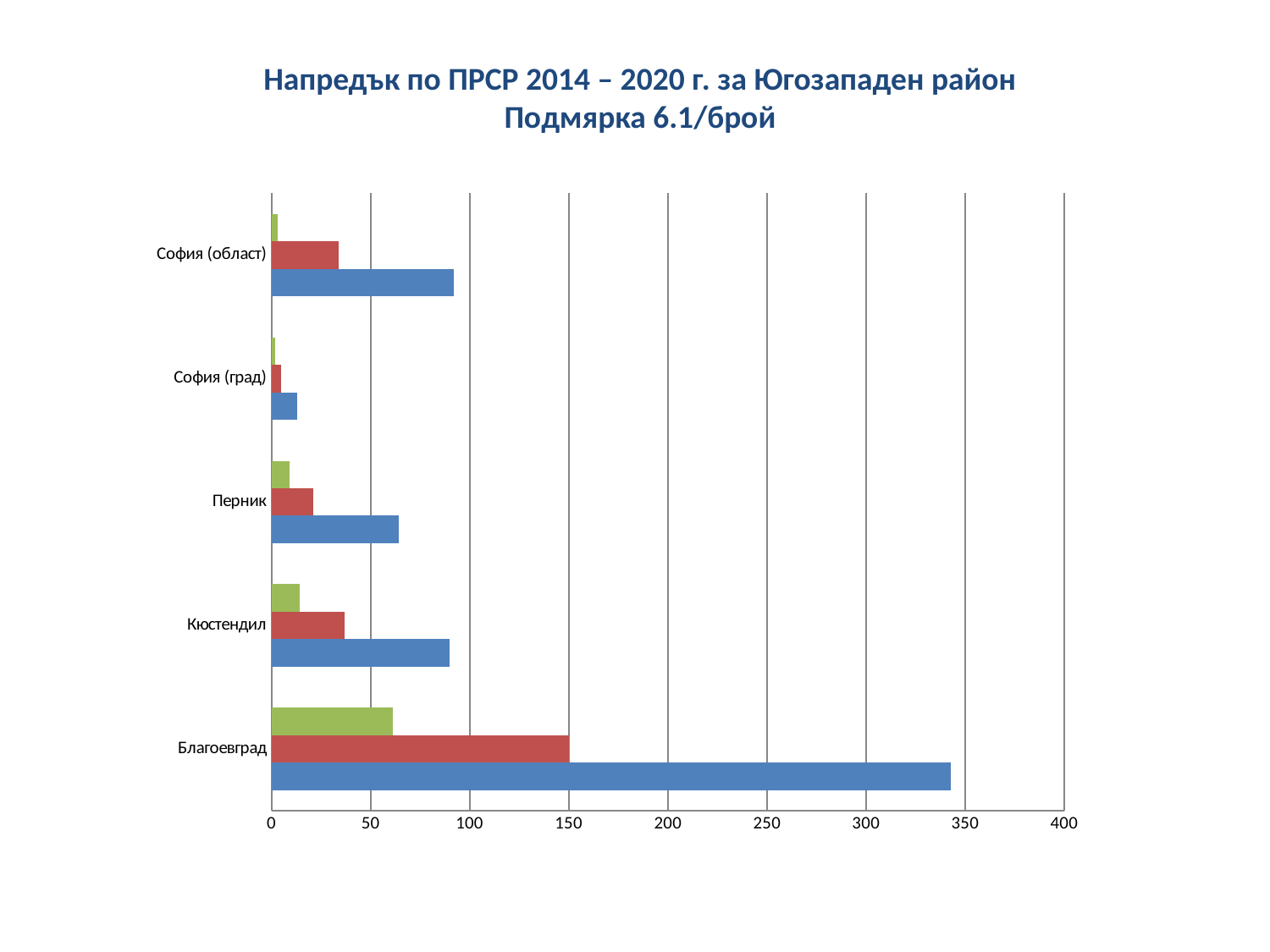
Which category has the longest blue bar? Благоевград Is the green bar for Благоевград greater or less than 50? greater What is the second line of the chart title? Подмярка 6.1/брой Is the red bar for София (област) greater or less than 50? less Is the blue bar for София (област) greater or less than 100? less Which category has the shortest blue bar? София (град) Which has the longer blue bar, Перник or Кюстендил? Кюстендил How many categories (regions) are shown on the vertical axis? 5 What kind of chart is shown on the slide? bar chart Which has the longer red bar, Благоевград or Кюстендил? Благоевград